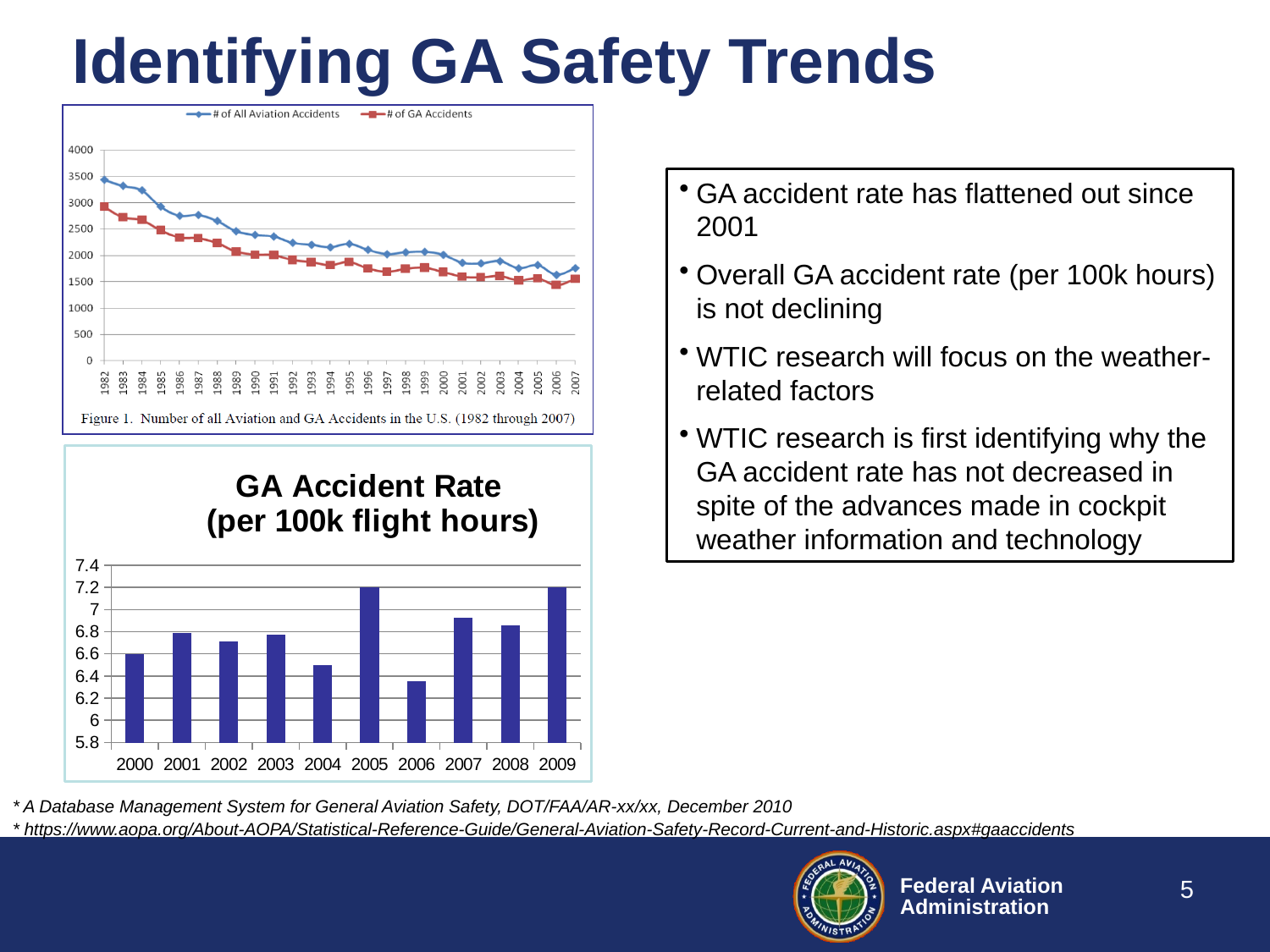
How many series does the legend of the top chart (Figure 1) list? 2 What kind of chart is the bottom chart titled 'GA Accident Rate (per 100k flight hours)'? bar chart In the bottom chart 'GA Accident Rate (per 100k flight hours)', is the value for 2007 greater or less than 6.8? greater In the top chart (Figure 1), is the number of all aviation accidents in 1982 greater or less than 3000? greater What kind of chart is the top chart (Figure 1)? line chart In the top chart (Figure 1), which series is higher in 1982: '# of All Aviation Accidents' or '# of GA Accidents'? # of All Aviation Accidents How many years are plotted on the x axis of the bottom chart 'GA Accident Rate (per 100k flight hours)'? 10 In the top chart (Figure 1), is the number of GA accidents in 2006 greater or less than 2000? less In the bottom chart 'GA Accident Rate (per 100k flight hours)', which year has the larger value: 2004 or 2005? 2005 In the top chart (Figure 1), do the number of all aviation accidents rise or fall from 1982 to 2007? fall In the bottom chart 'GA Accident Rate (per 100k flight hours)', which year has the lowest accident rate? 2006